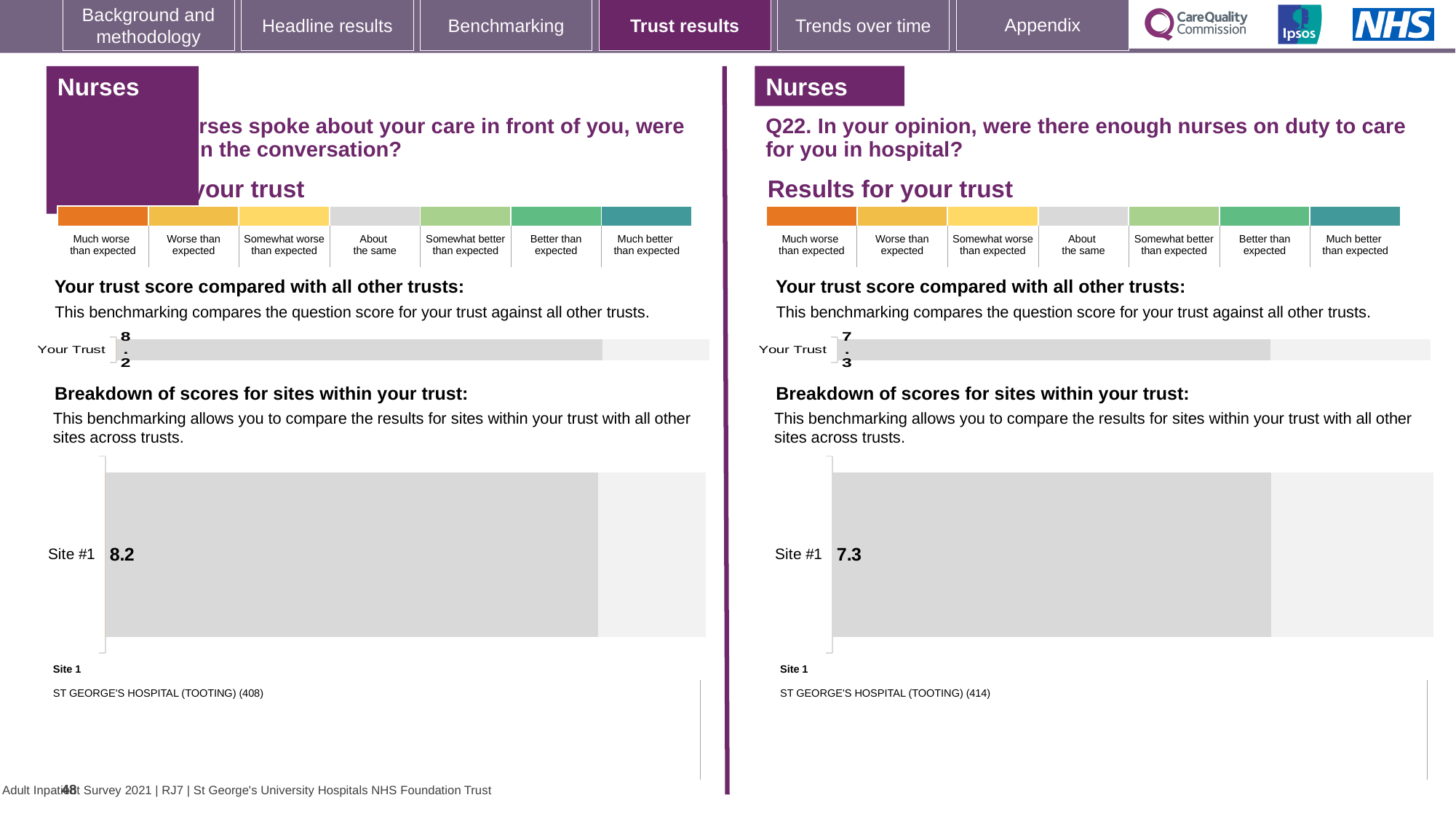
On the right panel (Q22), which site is listed as Site 1 below the breakdown chart? ST GEORGE'S HOSPITAL (TOOTING) (414) What is the difference between the Site #1 score on the left panel and the Site #1 score on the right panel (Q22)? 0.9 On the left panel, what score is shown for Site #1 in the 'Breakdown of scores for sites within your trust' chart? 8.2 On the right panel (Q22), is the Your Trust score the same as the Site #1 score? Yes On the left panel, which site is listed as Site 1 below the breakdown chart? ST GEORGE'S HOSPITAL (TOOTING) (408) What kind of chart is used to show the Site #1 score on the right panel (Q22)? Bar chart On the left panel, what is the value shown for Your Trust in the 'Your trust score compared with all other trusts' chart? 8.2 Which is larger: the Your Trust score on the left panel or the Your Trust score on the right panel (Q22)? Left panel How many sites are shown in the 'Breakdown of scores for sites within your trust' chart on the left panel? 1 On the right panel (Q22), what score is shown for Site #1 in the 'Breakdown of scores for sites within your trust' chart? 7.3 On the right panel (Q22), what is the value shown for Your Trust in the 'Your trust score compared with all other trusts' chart? 7.3